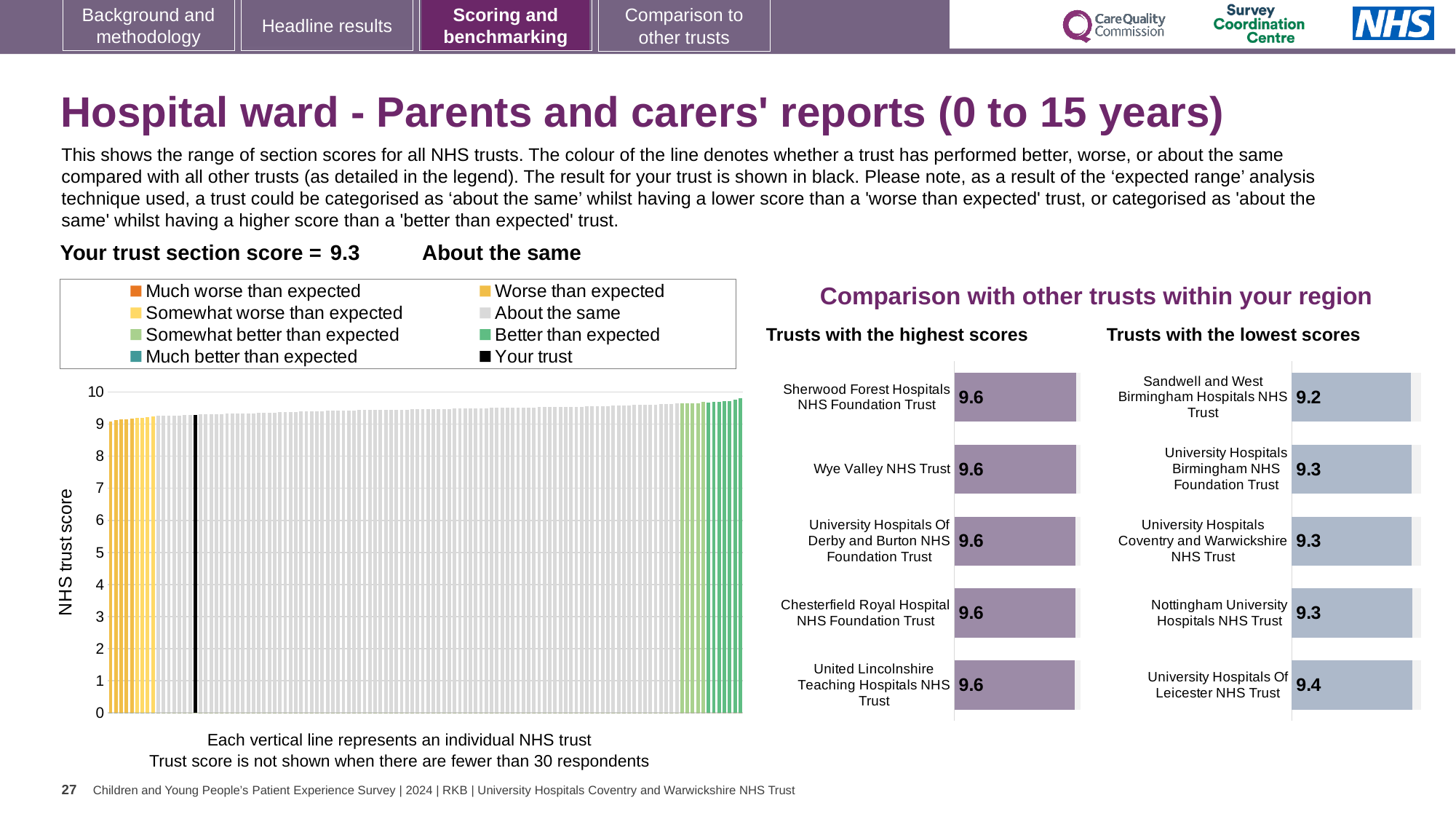
In the 'Trusts with the lowest scores' chart, which trust has the highest score? University Hospitals Of Leicester NHS Trust In the large 'NHS trust score' chart on the left, is the value for the black 'Your trust' bar greater or less than 9? greater In the 'Trusts with the lowest scores' chart, what is the score for Sandwell and West Birmingham Hospitals NHS Trust? 9.2 In the large 'NHS trust score' chart on the left, do the trust scores rise or fall from left to right? rise How many entries does the legend above the large 'NHS trust score' chart list? 8 In the 'Trusts with the highest scores' chart, what is the score for Wye Valley NHS Trust? 9.6 In the 'Trusts with the lowest scores' chart, what is the score for University Hospitals Of Leicester NHS Trust? 9.4 In the 'Trusts with the lowest scores' chart, what is the difference between the scores of University Hospitals Of Leicester NHS Trust and Sandwell and West Birmingham Hospitals NHS Trust? 0.2 How many trusts are shown in the 'Trusts with the highest scores' chart? 5 Comparing the two regional charts, what is the difference between the score of Sherwood Forest Hospitals NHS Foundation Trust and the score of Sandwell and West Birmingham Hospitals NHS Trust? 0.4 In the 'Trusts with the lowest scores' chart, which is larger: the score for Nottingham University Hospitals NHS Trust or the score for Sandwell and West Birmingham Hospitals NHS Trust? Nottingham University Hospitals NHS Trust In the 'Trusts with the lowest scores' chart, which trust has the lowest score? Sandwell and West Birmingham Hospitals NHS Trust